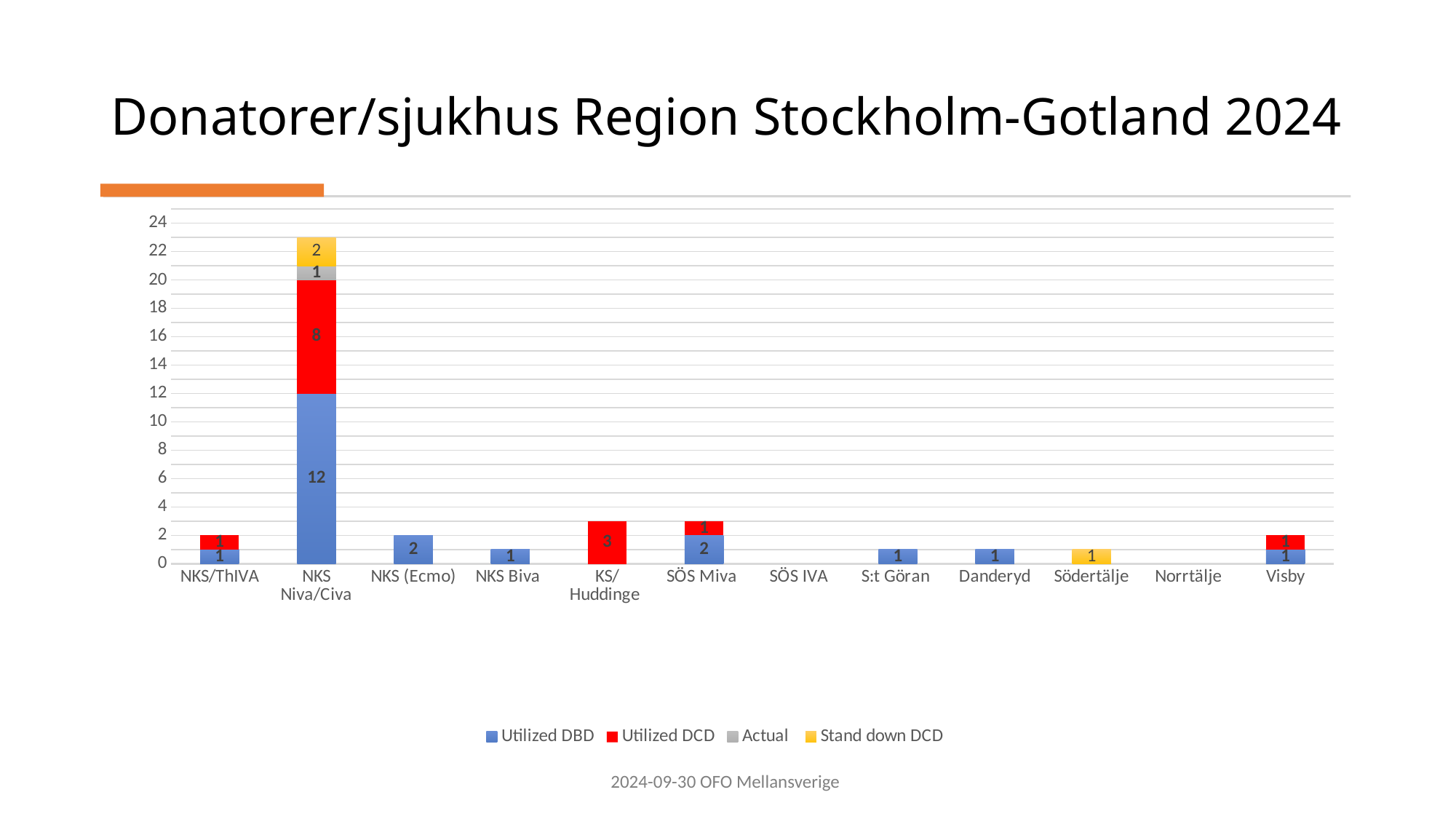
Which hospital has the highest total stacked bar? NKS Niva/Civa What is the total of the stacked bar for NKS Niva/Civa? 23 What is the Actual value for NKS Niva/Civa? 1 What kind of chart is shown on the slide? Stacked bar chart What is the Utilized DBD value for NKS Niva/Civa? 12 How many series does the legend list? 4 What is the Stand down DCD value for Södertälje? 1 What is the Utilized DCD value for KS/Huddinge? 3 What is the difference between the Utilized DBD and Utilized DCD values for NKS Niva/Civa? 4 Which is larger, the Utilized DBD value for NKS (Ecmo) or the Utilized DCD value for KS/Huddinge? Utilized DCD for KS/Huddinge What is the total of the stacked bar for SÖS Miva? 3 How many hospital categories are shown on the x axis? 12